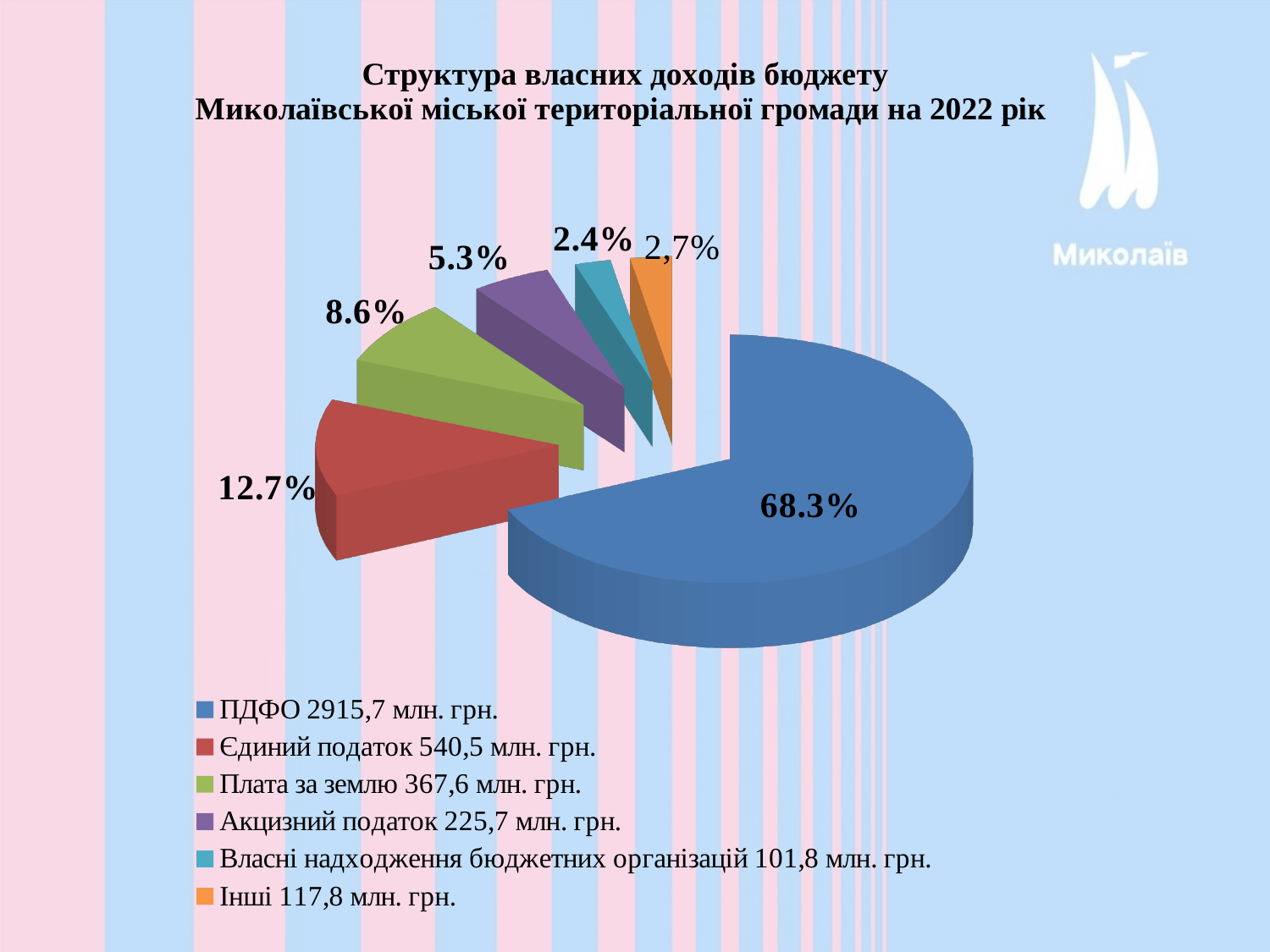
What kind of chart is shown on the slide? pie chart What percentage is shown for Акцизний податок? 5.3% What percentage is shown for Плата за землю? 8.6% Which category has the smallest slice of the pie? Власні надходження бюджетних організацій What percentage is shown for Власні надходження бюджетних організацій? 2.4% What percentage is shown for Єдиний податок? 12.7% What percentage is shown for Інші? 2,7% What share of the pie does ПДФО hold? 68.3% Which category has the largest slice of the pie? ПДФО How many slices does the pie chart have? 6 According to the legend, what amount in млн. грн. is given for Акцизний податок? 225,7 млн. грн. What is the difference in percentage points between the ПДФО slice and the Єдиний податок slice? 55.6